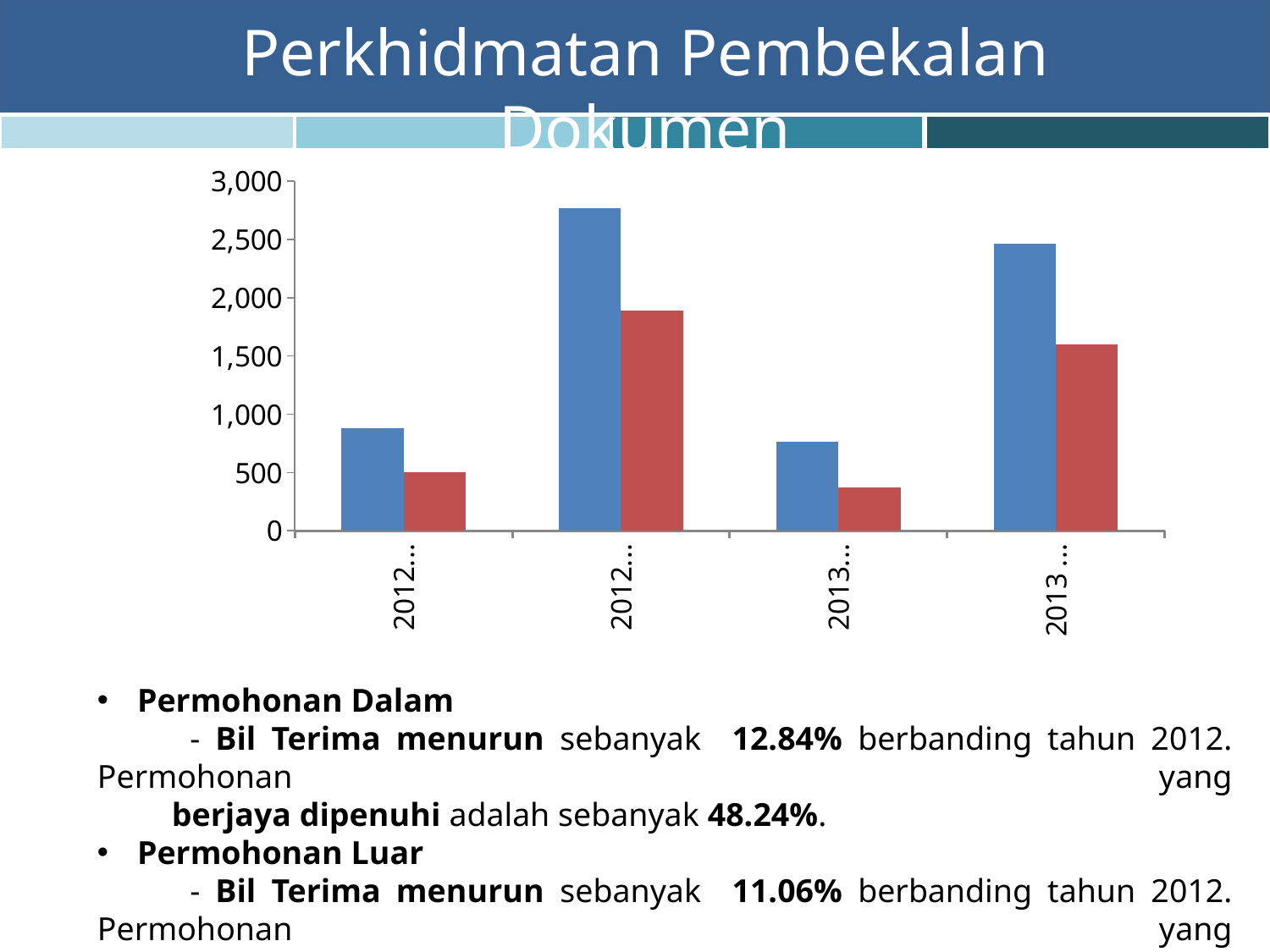
In the second category group, which bar is taller, the blue bar or the red bar? the blue bar Is the value of the red bar in the second category group greater or less than 1,500? greater What two colours are the bars in the chart? blue and red Which category group has the tallest blue bar? the second group Is the value of the blue bar in the second category group greater or less than 2,500? greater How many bars are plotted in each category group of the chart? 2 Is the value of the red bar in the fourth category group greater or less than 1,500? greater Which category group has the shortest red bar? the third group How many category groups are shown along the x axis of the chart? 4 What kind of chart is shown on the slide? bar chart